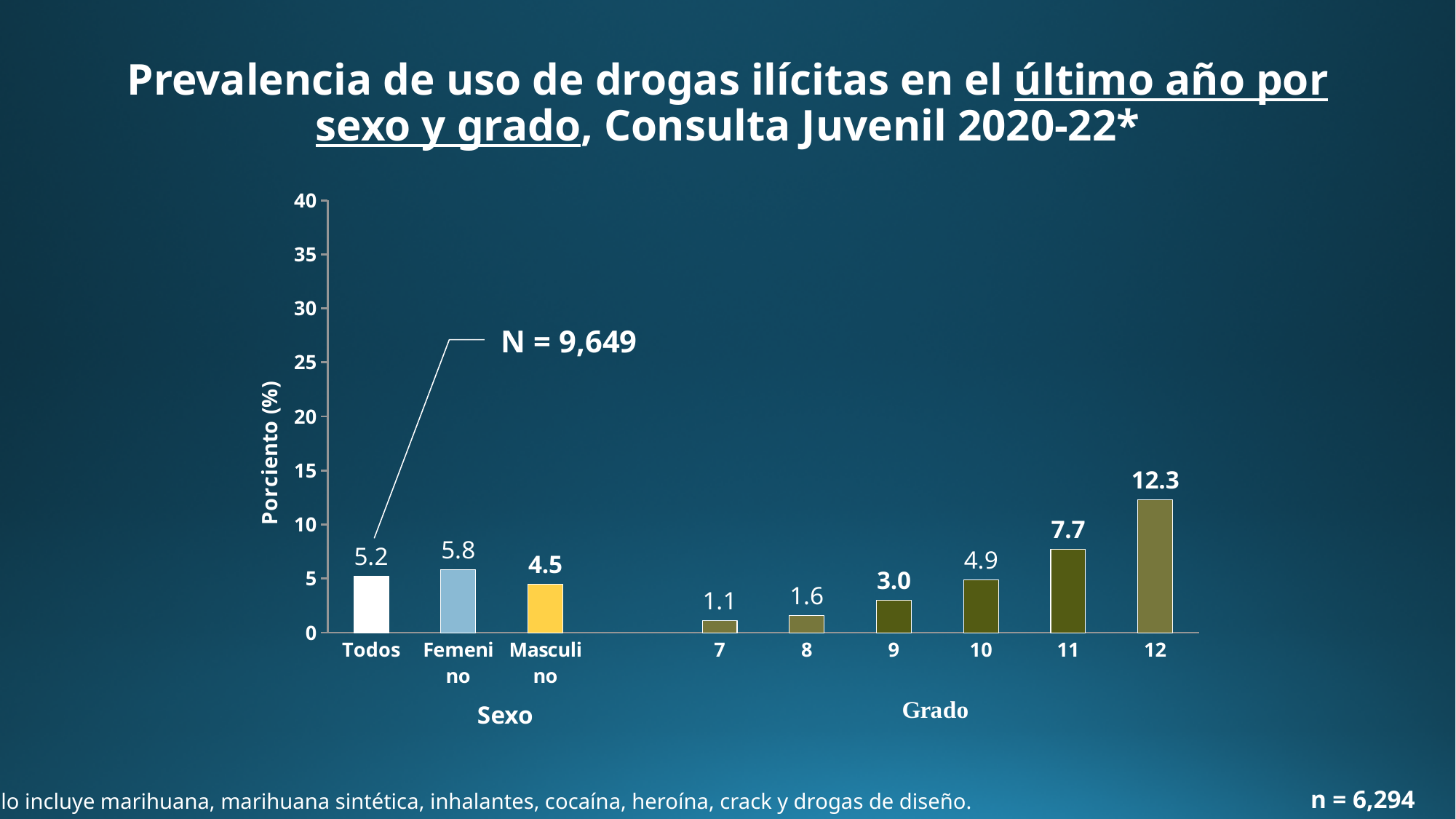
Which is larger, the value for grade 10 or the value for Masculino? grade 10 What is the value for Femenino? 5.8 Which category has the highest value? 12 What is the difference between the values for Femenino and Masculino? 1.3 What is the value for grade 12? 12.3 Do the values rise or fall from grade 7 to grade 12? rise What is the value for grade 9? 3.0 How many bars are plotted in the chart? 9 Which category has the lowest value? 7 What is the value for Todos? 5.2 What kind of chart is shown? bar chart What is the difference between the values for grade 12 and grade 11? 4.6